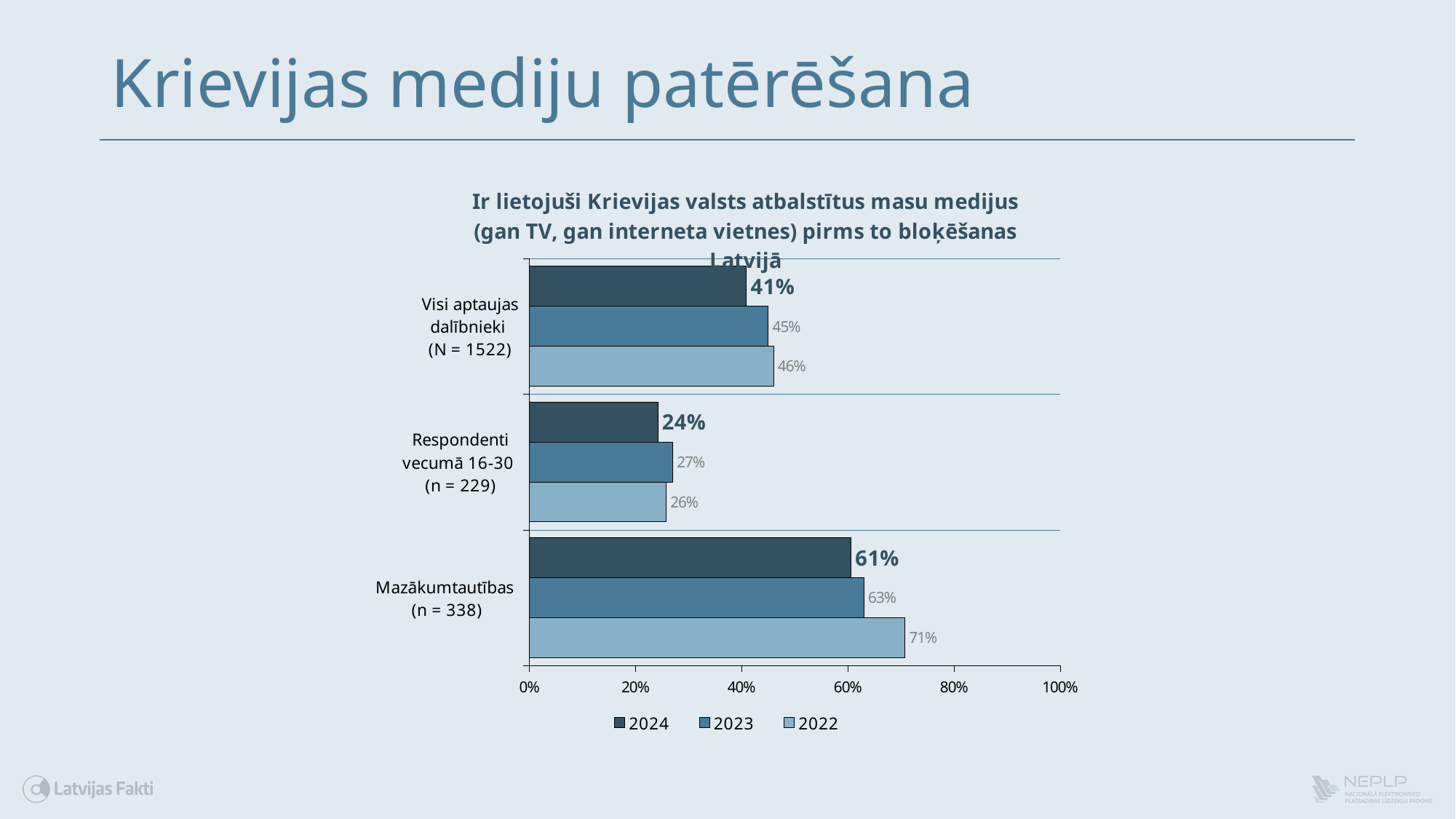
What is the 2023 value for Visi aptaujas dalībnieki (N = 1522)? 45% Which category has the lowest 2022 value? Respondenti vecumā 16-30 (n = 229) For Visi aptaujas dalībnieki (N = 1522), which is larger: the 2023 value or the 2024 value? 2023 What is the 2022 value for Respondenti vecumā 16-30 (n = 229)? 26% How many categories are shown on the chart? 3 Is the 2022 value for Mazākumtautības (n = 338) greater or less than 60%? greater What is the difference between the 2022 and 2024 values for Mazākumtautības (n = 338)? 10% What kind of chart is shown on the slide? Bar chart Which years are listed in the chart legend? 2024, 2023, 2022 What is the 2024 value for Mazākumtautības (n = 338)? 61% Which category has the highest 2024 value? Mazākumtautības (n = 338) How many series does the legend list? 3